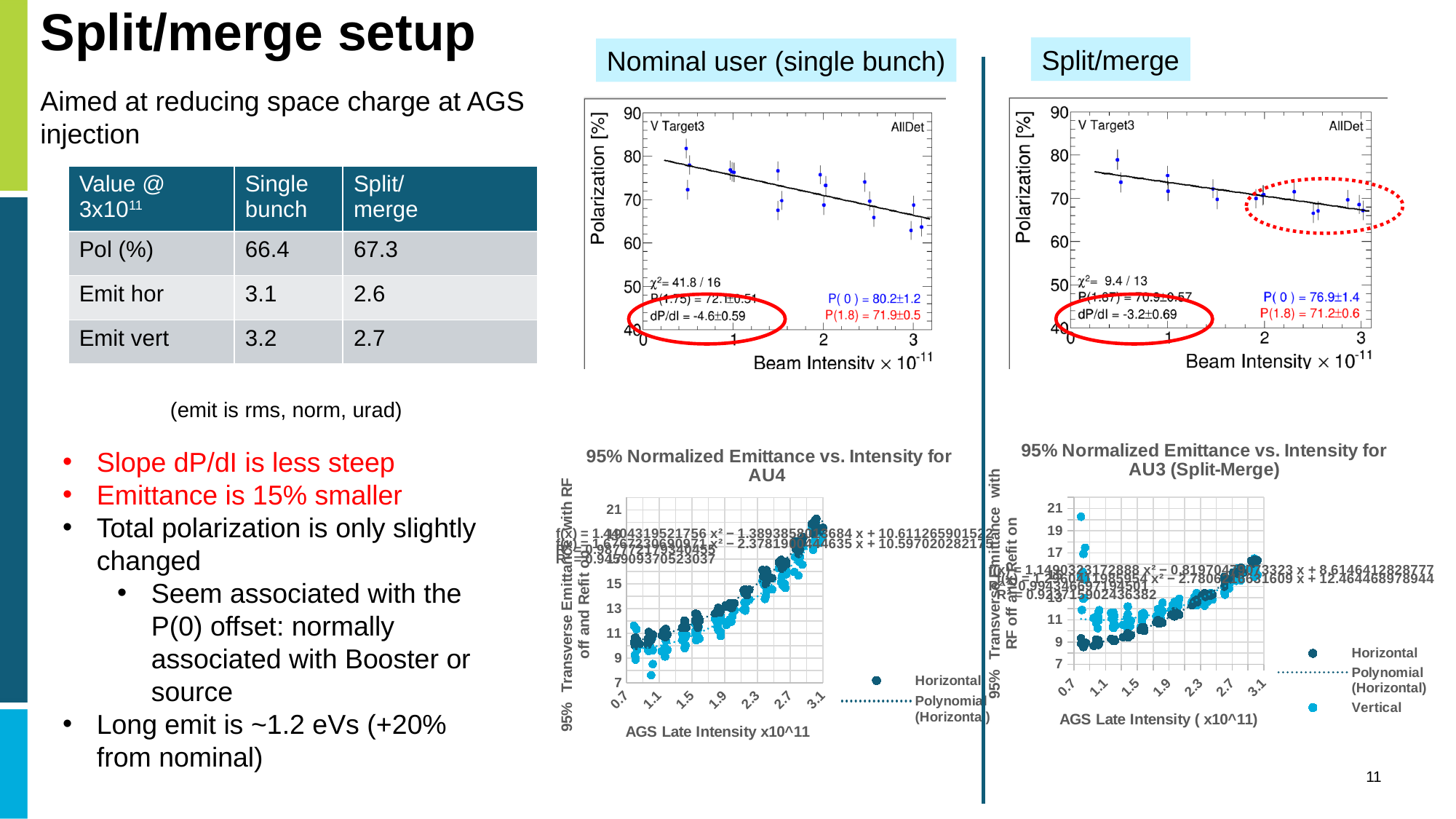
In the 'Split/merge' polarization chart, what is the printed value of P(1.8)? 71.2±0.6 In the '95% Normalized Emittance vs. Intensity for AU4' chart, does emittance rise or fall as AGS Late Intensity increases? rise What is the y-axis label of the 'Split/merge' polarization chart? Polarization [%] What kind of chart is the '95% Normalized Emittance vs. Intensity for AU3 (Split-Merge)' chart? scatter chart In the 'Nominal user (single bunch)' polarization chart, what is the printed value of dP/dI? -4.6±0.59 What is the x-axis label of the '95% Normalized Emittance vs. Intensity for AU4' chart? AGS Late Intensity x10^11 In the 'Split/merge' polarization chart, what is the printed χ² value? 9.4 / 13 Which chart has the steeper (more negative) dP/dI slope, 'Nominal user (single bunch)' or 'Split/merge'? Nominal user (single bunch) In the 'Nominal user (single bunch)' polarization chart, does polarization rise or fall as beam intensity increases? fall How many entries does the legend of the '95% Normalized Emittance vs. Intensity for AU3 (Split-Merge)' chart list? 3 In the 'Split/merge' polarization chart, what is the printed value of dP/dI? -3.2±0.69 In the 'Nominal user (single bunch)' polarization chart, what is the printed value of P(0)? 80.2±1.2